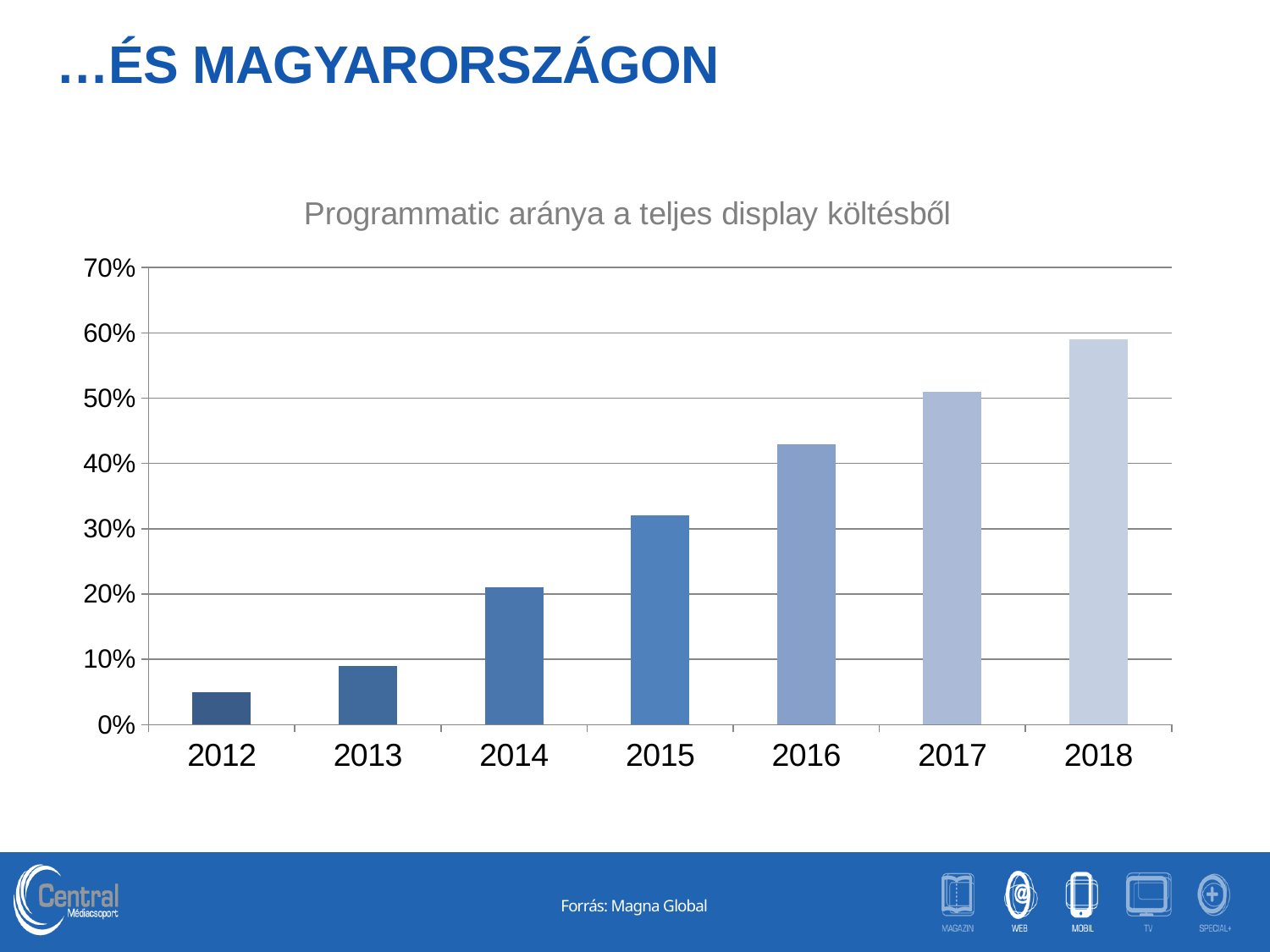
Is the value for 2016 greater or less than 40%? greater Do the values rise or fall from 2012 to 2018? rise What kind of chart is shown on the slide? bar chart Which year has the highest value in the chart? 2018 Is the value for 2018 greater or less than 50%? greater How many years are shown on the x axis of the chart? 7 Which year has the lowest value in the chart? 2012 Which year has the larger value, 2015 or 2016? 2016 Is the value for 2017 greater or less than 60%? less What is the title of the chart? Programmatic aránya a teljes display költésből